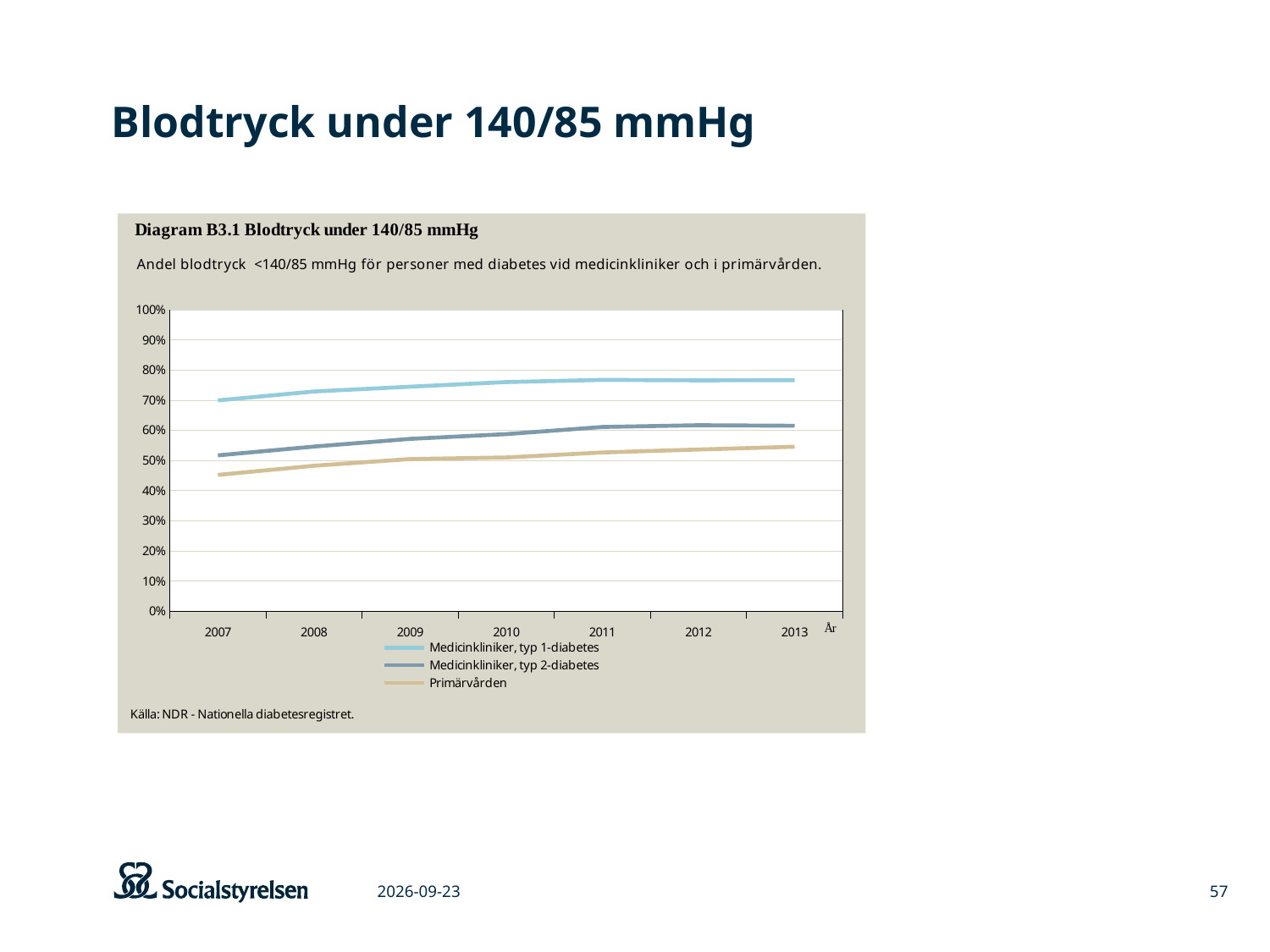
What source is cited below the chart? NDR - Nationella diabetesregistret Is the value for Medicinkliniker, typ 1-diabetes in 2013 greater or less than 80%? less What is the title of the diagram shown on the slide? Diagram B3.1 Blodtryck under 140/85 mmHg Does the value for Primärvården rise or fall from 2007 to 2013? Rise How many years are shown on the x axis? 7 What kind of chart is shown on the slide? Line chart How many series does the legend list? 3 In 2013, which is larger: Medicinkliniker, typ 1-diabetes or Primärvården? Medicinkliniker, typ 1-diabetes Is the value for Primärvården in 2007 greater or less than 50%? less Is the value for Medicinkliniker, typ 2-diabetes in 2013 greater or less than 50%? greater Which series has the highest values across all years? Medicinkliniker, typ 1-diabetes Which series has the lowest values across all years? Primärvården